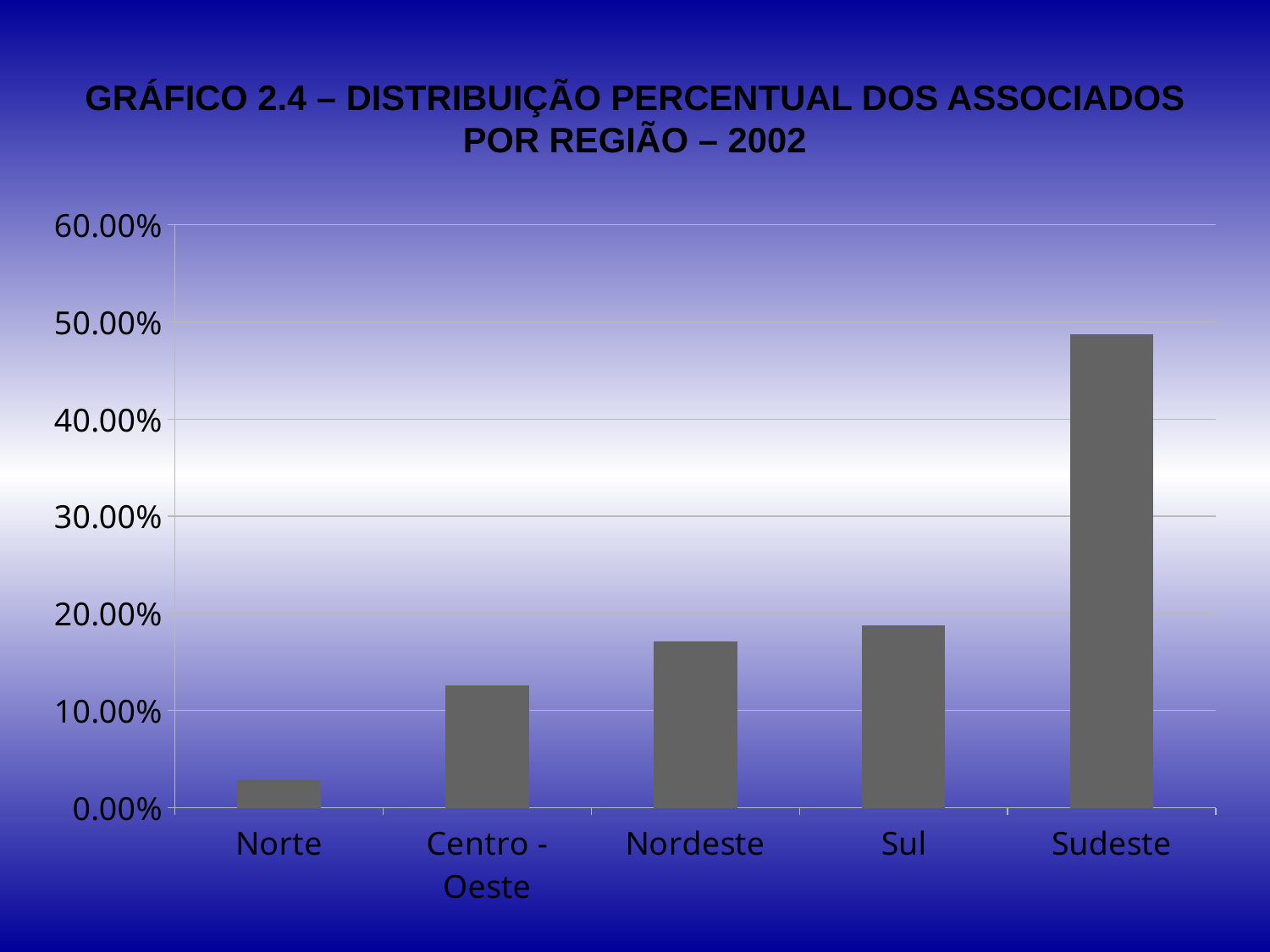
Is the value for Norte greater or less than 10.00%? less What kind of chart is shown on the slide? bar chart Is the value for Sul greater or less than 20.00%? less Which region has the highest percentage of associados? Sudeste Is the value for Sudeste greater or less than 40.00%? greater Which is larger, the value for Centro - Oeste or the value for Norte? Centro - Oeste How many regions are shown on the x axis of the chart? 5 Which region has the lowest percentage of associados? Norte What is the title of the chart on the slide? GRÁFICO 2.4 – DISTRIBUIÇÃO PERCENTUAL DOS ASSOCIADOS POR REGIÃO – 2002 Which is larger, the value for Sudeste or the value for Sul? Sudeste